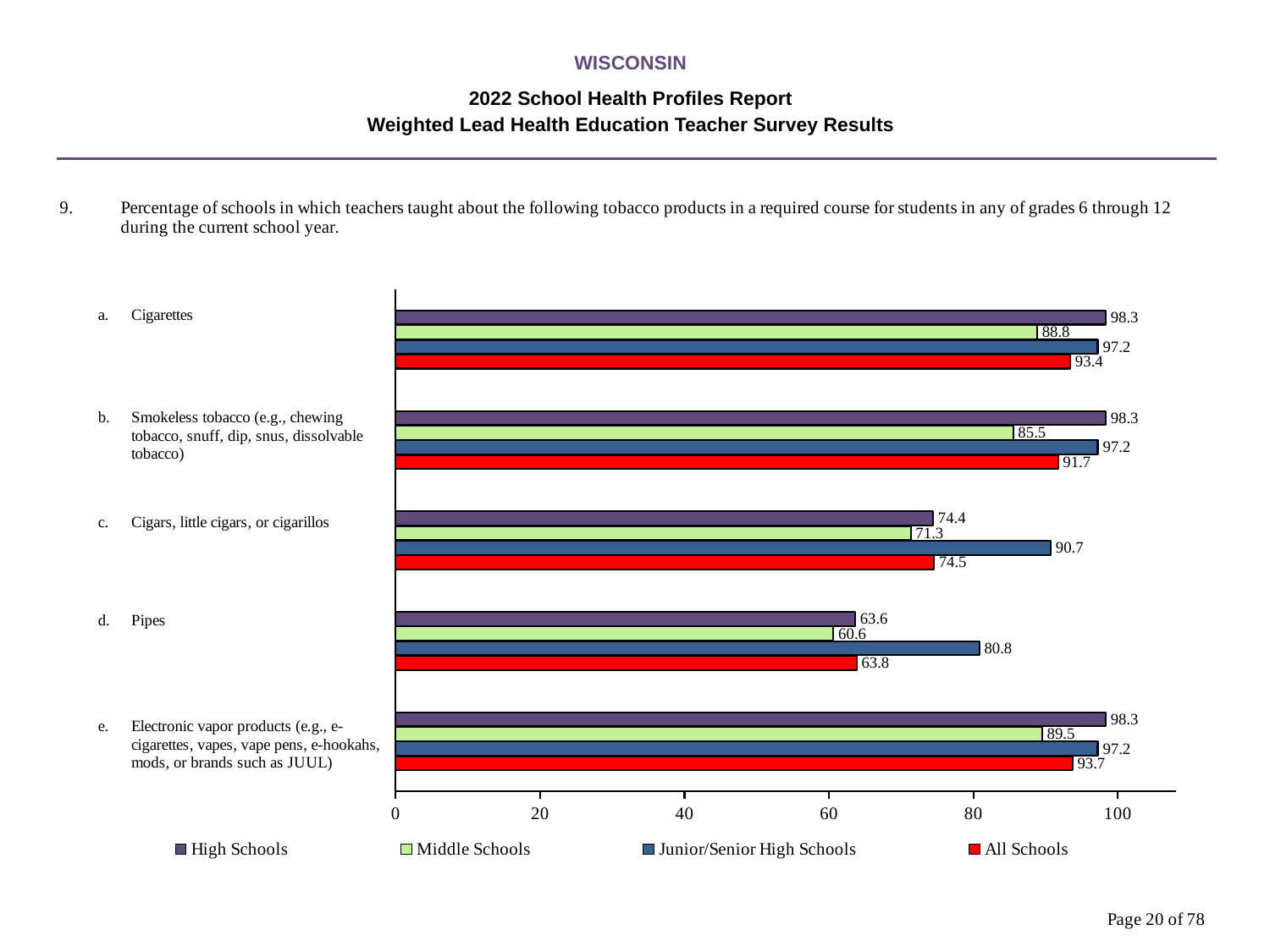
What kind of chart is shown on the slide? bar chart What is the All Schools value for Cigars, little cigars, or cigarillos? 74.5 Is the Middle Schools value for Cigars, little cigars, or cigarillos greater or less than 80? less How many series does the legend list? 4 Which category has the highest value for Junior/Senior High Schools? Cigarettes, Smokeless tobacco, and Electronic vapor products (all 97.2) What is the value for Junior/Senior High Schools for Pipes? 80.8 Which category has the lowest value for Middle Schools? Pipes What is the difference between the High Schools and Middle Schools values for Smokeless tobacco? 12.8 What is the value for Middle Schools for Cigarettes? 88.8 How many tobacco product categories are shown in the chart? 5 For Pipes, which is larger: the High Schools value or the Junior/Senior High Schools value? Junior/Senior High Schools What colour represents All Schools in the chart? red